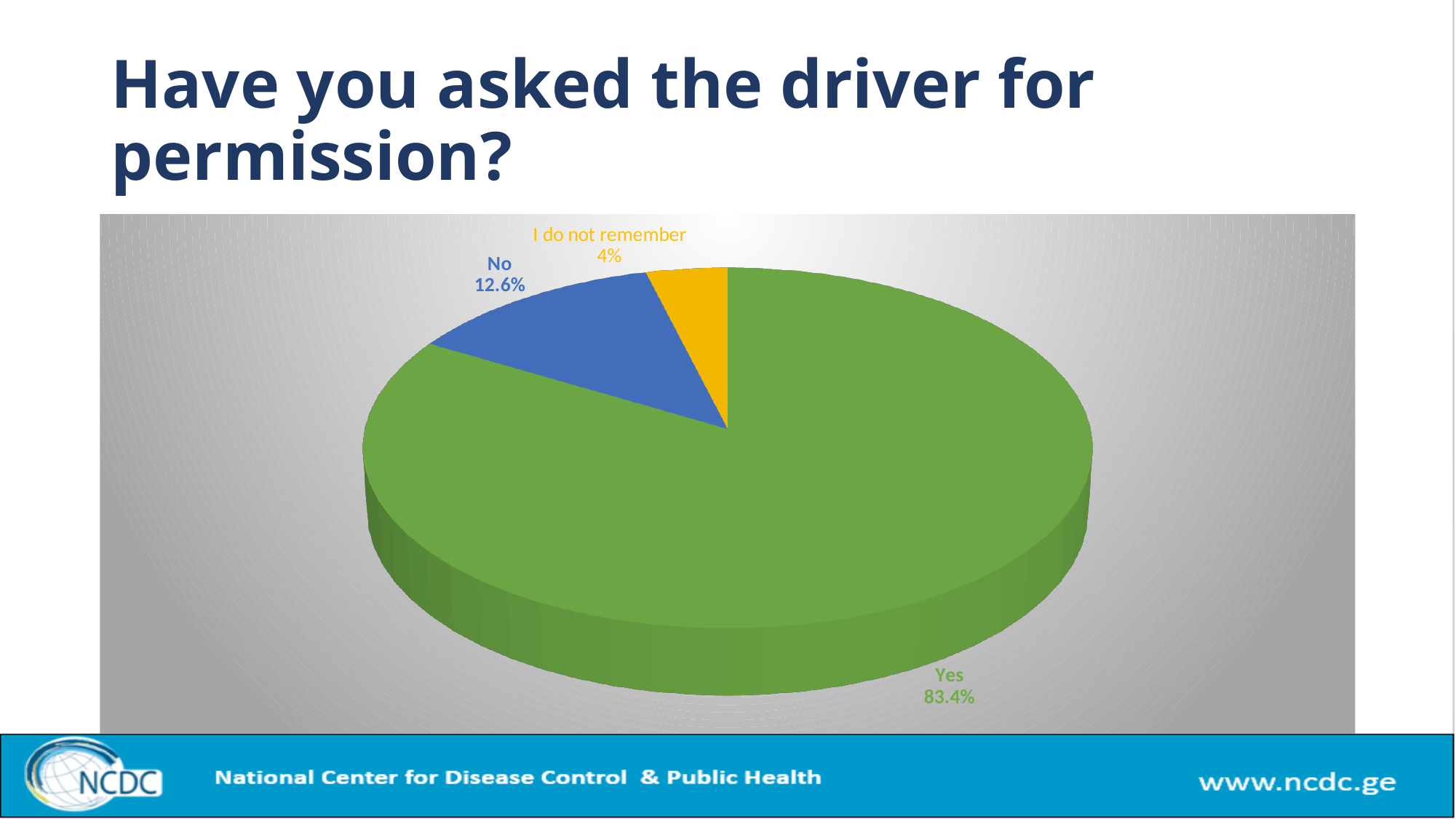
What colour is the "Yes" slice? Green What percentage of respondents answered "Yes"? 83.4% What is the difference in percentage points between the "No" and "I do not remember" slices? 8.6 What is the difference in percentage points between the "Yes" and "No" slices? 70.8 Which is larger, the "No" slice or the "I do not remember" slice? No Which response has the largest share of the pie? Yes What type of chart is shown on the slide? Pie chart Which response has the smallest share of the pie? I do not remember What is the title of the slide? Have you asked the driver for permission? How many slices does the pie chart have? 3 What percentage of respondents answered "No"? 12.6% What percentage of respondents answered "I do not remember"? 4%